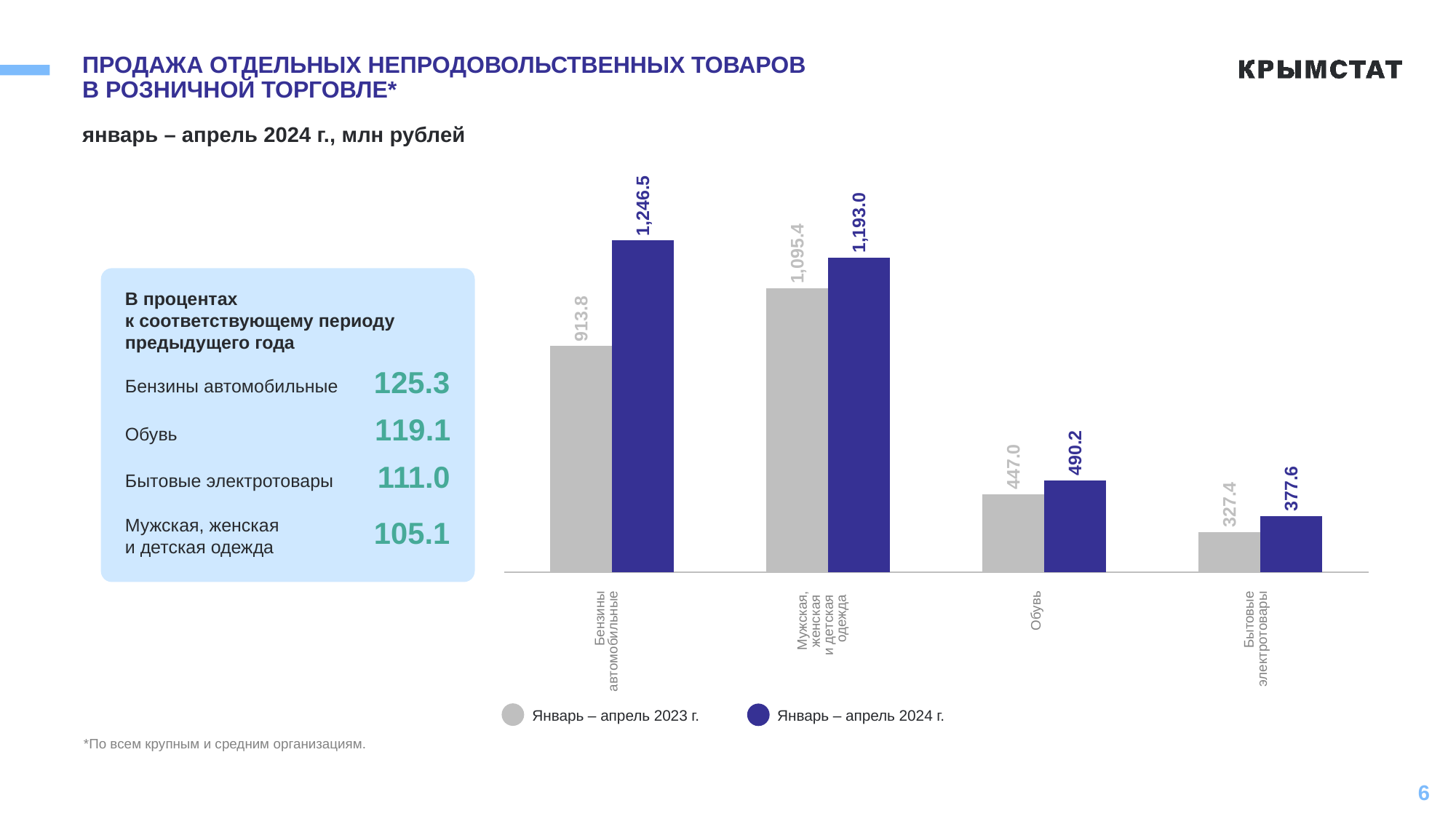
What colour represents the Январь – апрель 2023 г. series in the chart? Grey How many series does the chart legend list? 2 What is the value for Бытовые электротовары for Январь – апрель 2024 г.? 377.6 What is the value for Обувь for Январь – апрель 2023 г.? 447.0 How many product categories are shown on the chart? 4 What is the difference between the Январь – апрель 2024 г. and Январь – апрель 2023 г. values for Бензины автомобильные? 332.7 Which category has the highest value for Январь – апрель 2024 г.? Бензины автомобильные What type of chart is shown on the slide? Bar chart What is the value for Мужская, женская и детская одежда for Январь – апрель 2023 г.? 1,095.4 Which is larger for Мужская, женская и детская одежда: the Январь – апрель 2023 г. value or the Январь – апрель 2024 г. value? Январь – апрель 2024 г. What is the value for Бензины автомобильные for Январь – апрель 2024 г.? 1,246.5 Which category has the lowest value for Январь – апрель 2023 г.? Бытовые электротовары